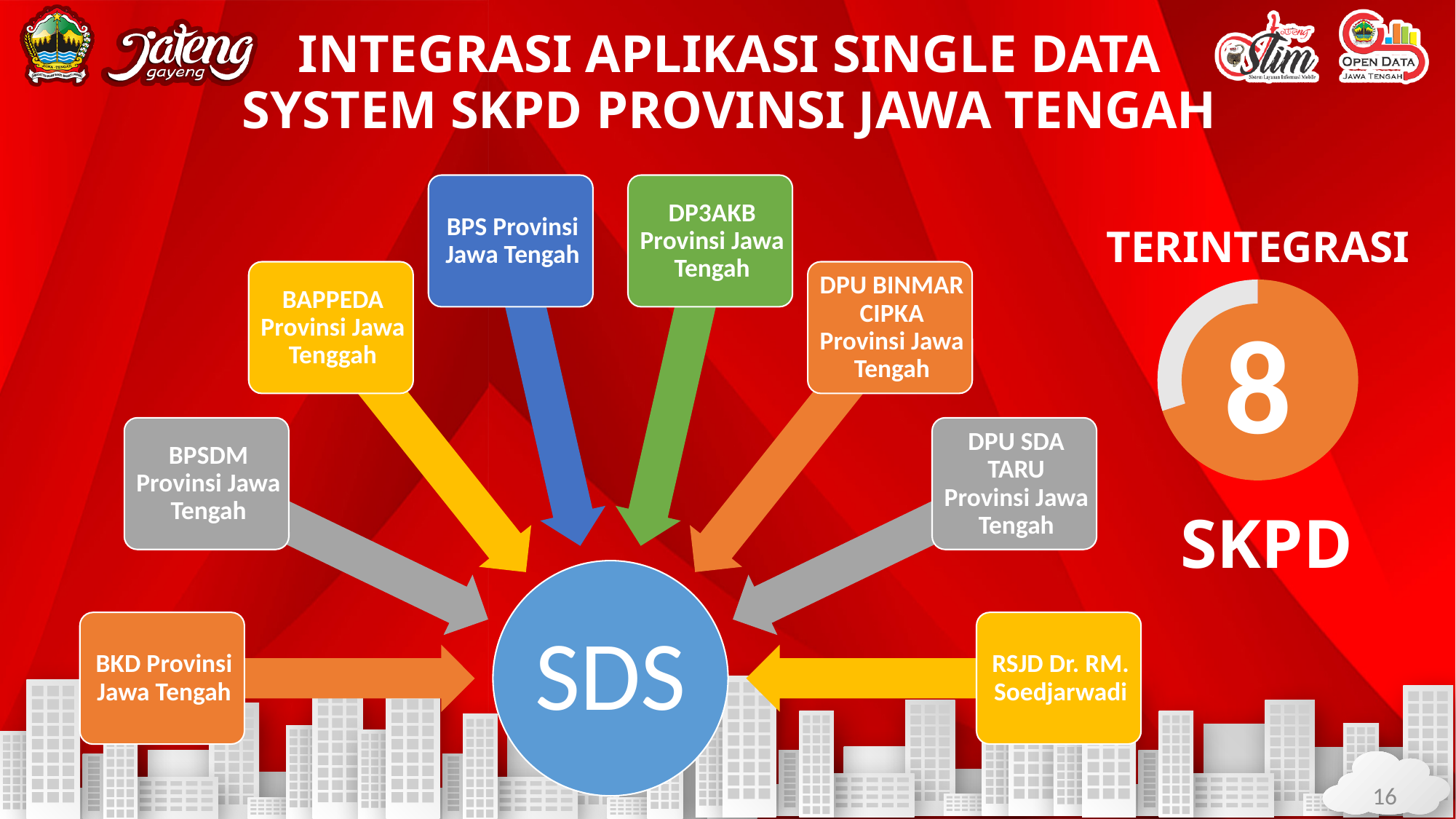
What number is shown inside the orange ring graphic on the right of the slide? 8 What word appears below the orange ring graphic on the right of the slide? SKPD What label is written in the central blue circle of the diagram? SDS What word appears above the orange ring graphic on the right of the slide? TERINTEGRASI How many SKPD boxes point arrows into the central SDS circle in the diagram? 8